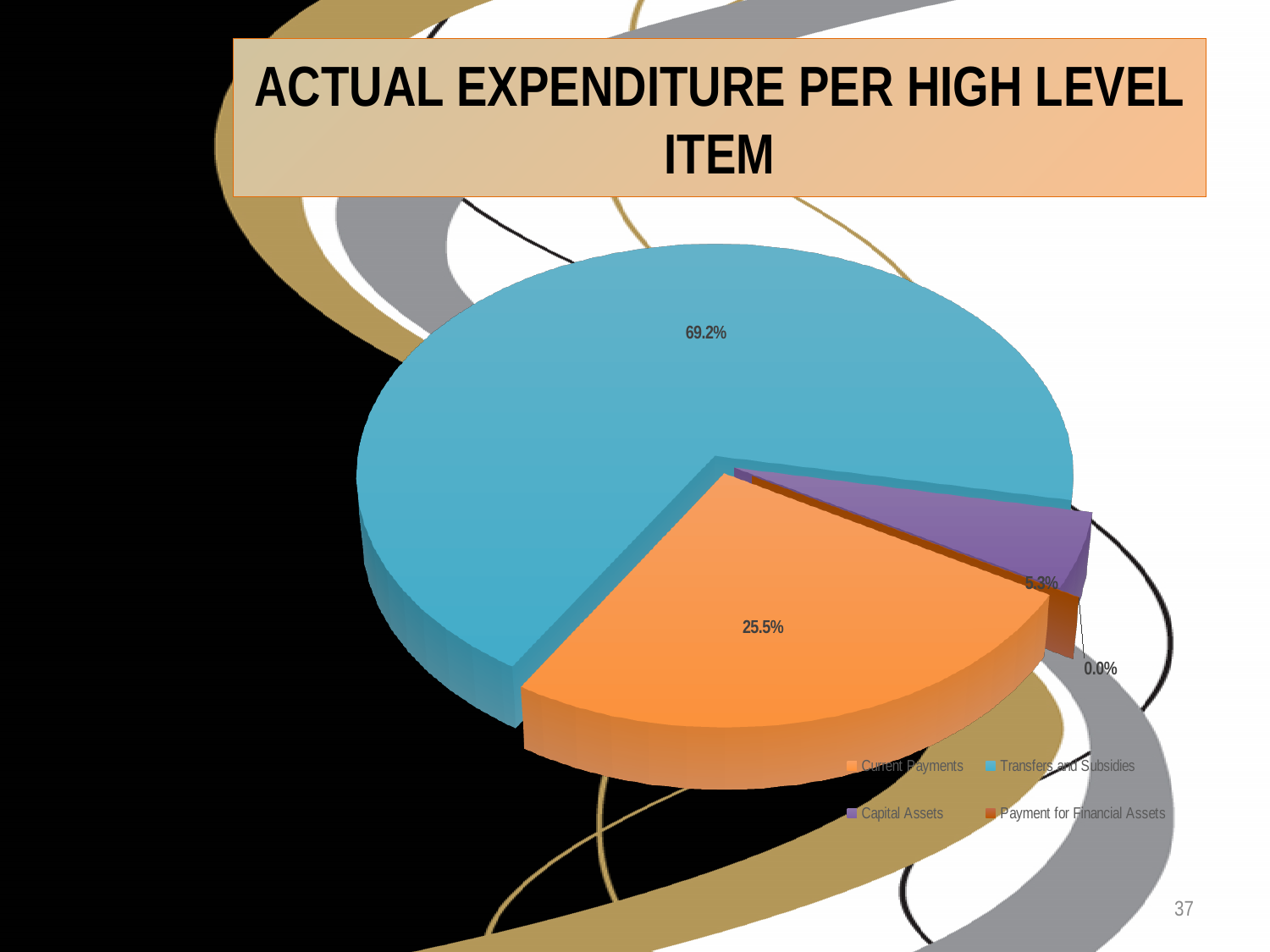
How many entries does the legend list? 4 What share of actual expenditure is Transfers and Subsidies? 69.2% What share of actual expenditure is Payment for Financial Assets? 0.0% What kind of chart is shown on the slide? Pie chart Which high level item has the largest share of actual expenditure? Transfers and Subsidies Which is larger, the share for Current Payments or the share for Capital Assets? Current Payments How many slices does the pie chart have? 4 What is the title of the slide containing the pie chart? ACTUAL EXPENDITURE PER HIGH LEVEL ITEM What is the difference in percentage points between Transfers and Subsidies and Current Payments? 43.7 What share of actual expenditure is Current Payments? 25.5% Which high level item has the smallest share of actual expenditure? Payment for Financial Assets